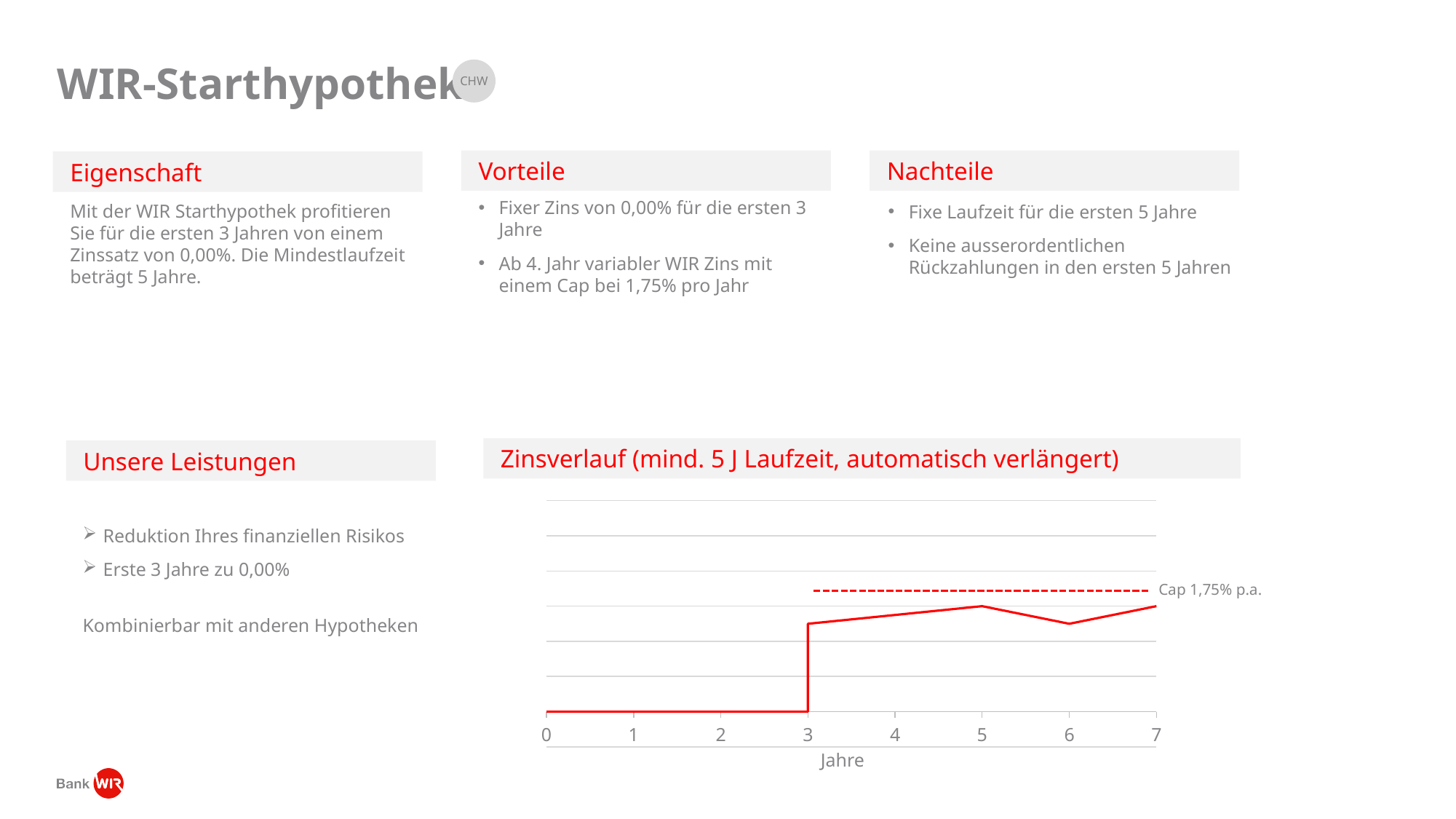
In the Zinsverlauf chart, does the red line rise or fall between year 6 and year 7? rises What is the last year shown on the x axis of the Zinsverlauf chart? 7 At which year does the red line in the Zinsverlauf chart first jump up from its flat start? 3 In the Zinsverlauf chart, is the red line at year 5 higher or lower than at year 6? higher How many year ticks are shown on the x axis of the Zinsverlauf chart? 8 In the Zinsverlauf chart, does the red line rise or fall between year 3 and year 5? rises In the Zinsverlauf chart, does the red line rise, fall or stay flat between year 0 and year 3? stays flat What kind of chart is shown under the title "Zinsverlauf (mind. 5 J Laufzeit, automatisch verlängert)"? line chart What is the label of the x axis of the Zinsverlauf chart? Jahre In the Zinsverlauf chart, is the red line above or below the dashed cap line after year 3? below What is the label on the dashed horizontal line in the Zinsverlauf chart? Cap 1,75% p.a.